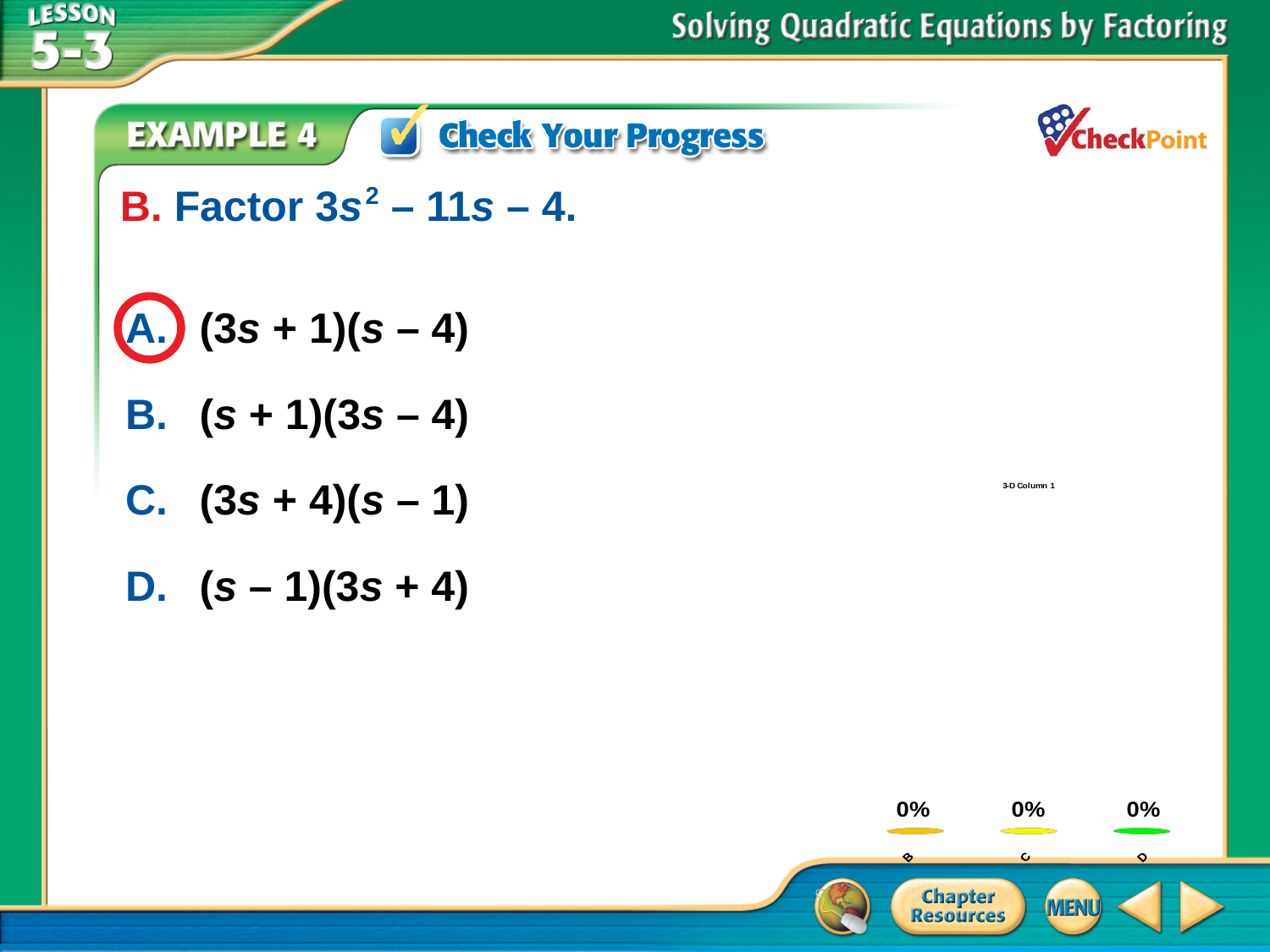
What is the difference between the values for B and D in the chart at the bottom right of the slide? 0% What kind of chart is shown at the bottom right of the slide? bar chart In the chart at the bottom right of the slide, is the value for C greater or less than 50%? less What value is shown for category D in the chart at the bottom right of the slide? 0% What value is shown for category C in the chart at the bottom right of the slide? 0% What value is shown for category B in the chart at the bottom right of the slide? 0% What is the title of the chart at the bottom right of the slide? 3-D Column 1